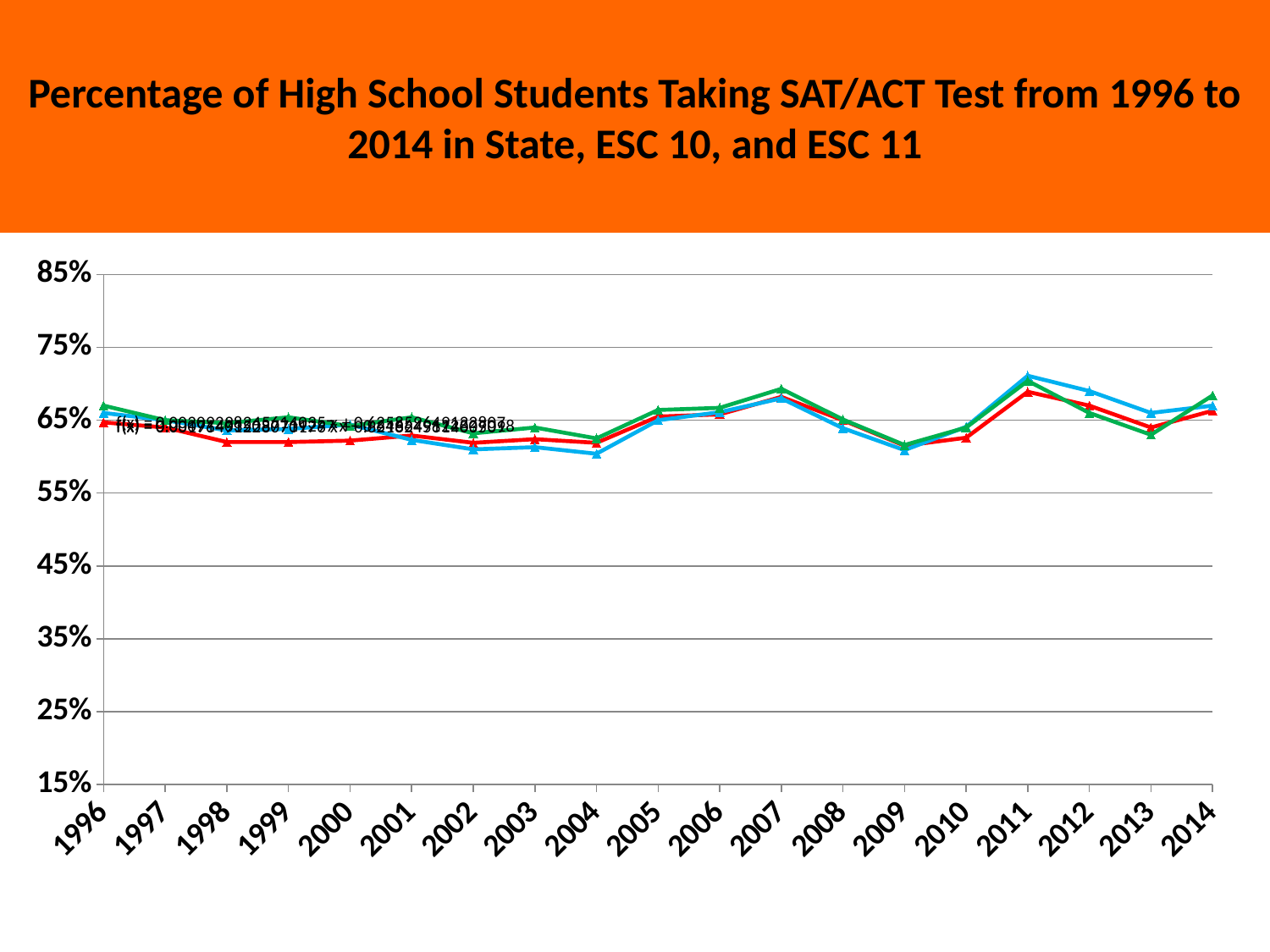
What is the highest value shown on the y axis of the chart? 85% What kind of chart is shown on the slide? line chart Is the value of the blue line in 2011 greater or less than 75%? less Is the value of the green line in 2011 greater or less than 65%? greater Do the lines rise or fall between 2009 and 2011? rise Is the value of the blue line in 2004 greater or less than 65%? less Does the green line rise or fall between 2011 and 2013? fall In which year does the green line reach its highest value? 2011 How many lines are plotted on the chart? 3 What is the title of the chart? Percentage of High School Students Taking SAT/ACT Test from 1996 to 2014 in State, ESC 10, and ESC 11 How many years are shown along the x axis of the chart? 19